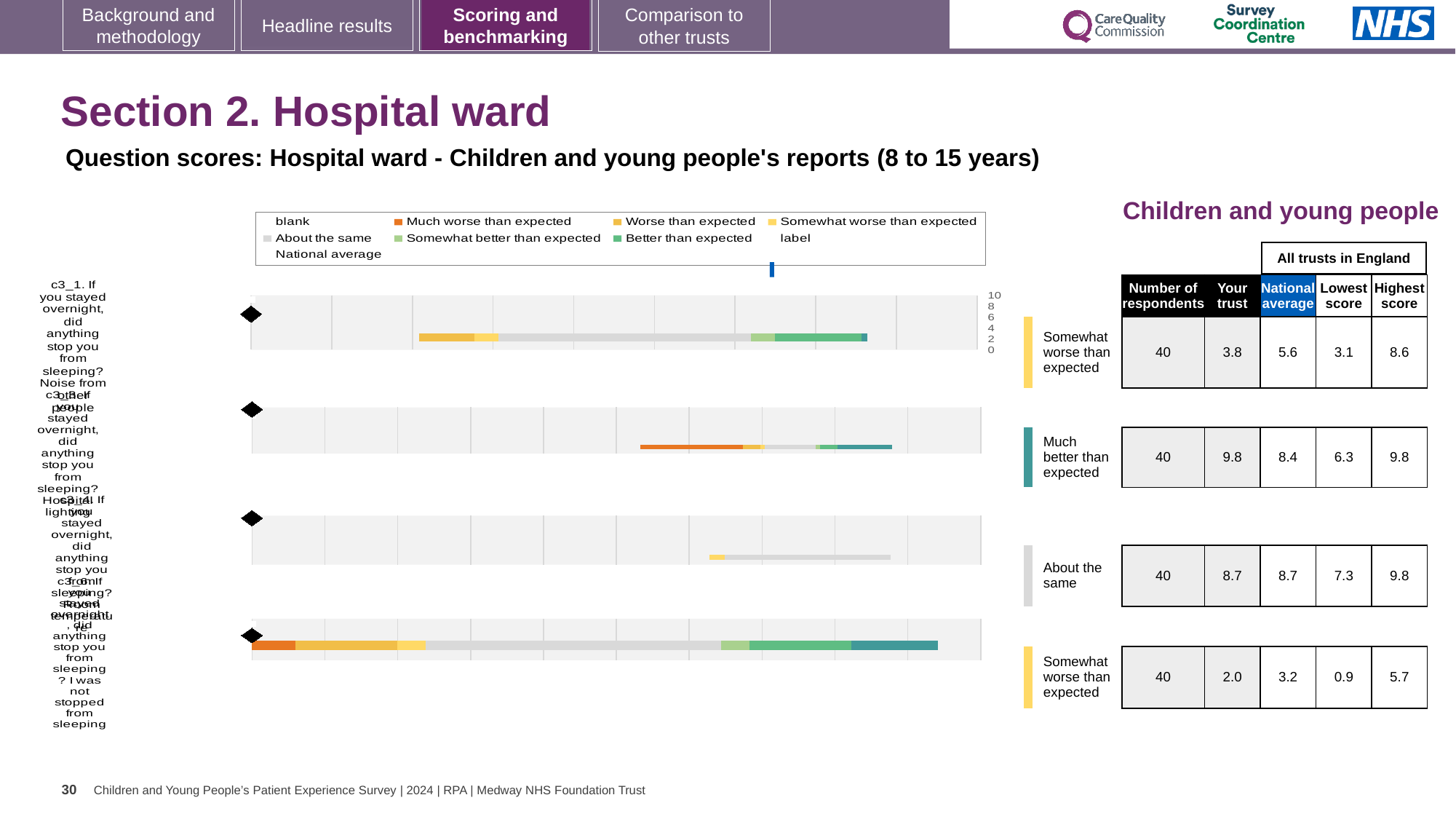
In the table, what is the difference between the highest score and the lowest score for the 'About the same' row? 2.5 How many question bars (charts) are plotted on the slide? 4 What colour does the legend use for 'Much worse than expected'? orange What is the heading above the table on the right of the slide? Children and young people In the table's last row (Somewhat worse than expected, 2.0), which is larger: the 'Your trust' score or the national average? National average In the table, what is the national average for the 'Much better than expected' row? 8.4 Which table row has the highest 'Your trust' score? Much better than expected What kind of chart is used to show the question scores on this slide? bar chart In the table, what is the 'Your trust' score for the first row (Somewhat worse than expected)? 3.8 How many entries does the chart legend list? 9 What is the smallest value in the 'Lowest score' column of the table? 0.9 In the table, how many respondents are listed for the 'About the same' row? 40